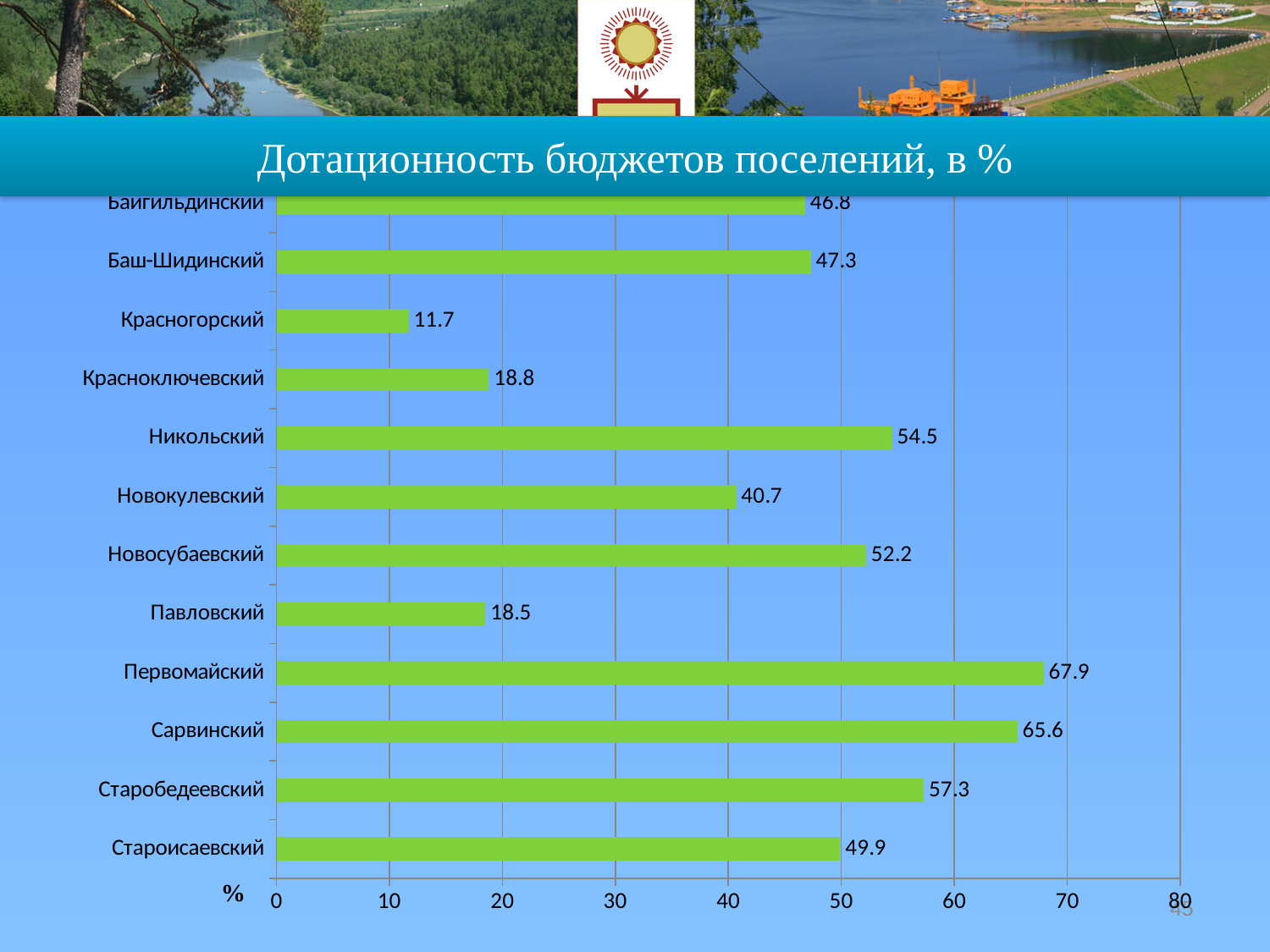
Which category has the highest value? Первомайский What is the value for Первомайский? 67.9 Which is larger, the value for Новосубаевский or the value for Новокулевский? Новосубаевский Is the value for Красноключевский greater or less than 20? less What kind of chart is shown on the slide? bar chart How many categories are shown in the chart? 12 What is the value for Никольский? 54.5 What is the value for Красногорский? 11.7 Which category has the lowest value? Красногорский What is the title of the chart? Дотационность бюджетов поселений, в % What is the difference between the values for Старобедеевский and Староисаевский? 7.4 What is the difference between the values for Первомайский and Сарвинский? 2.3